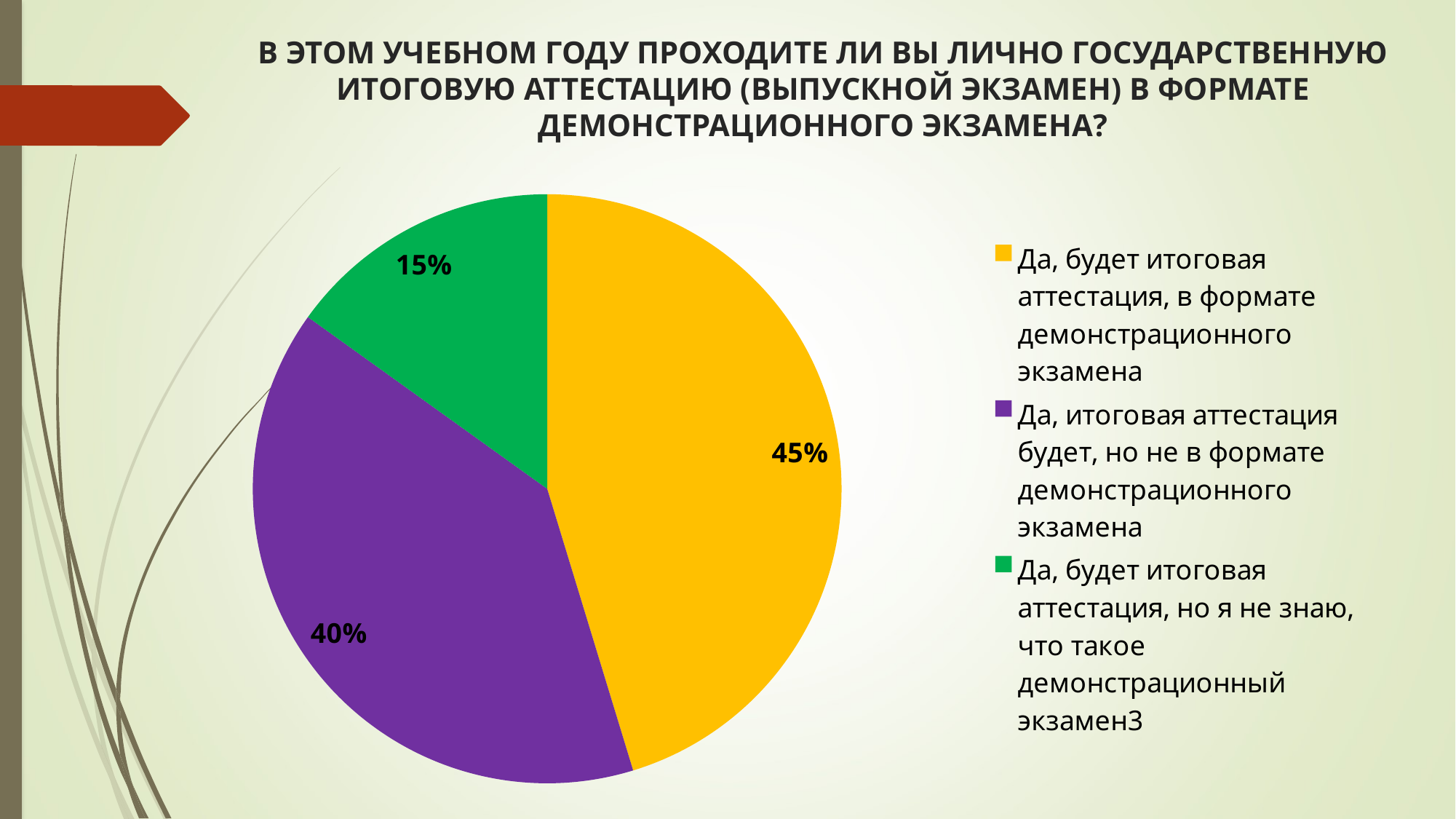
What colour is the slice representing 15%? green Which slice is larger: the purple one or the green one? the purple one What kind of chart is shown on the slide? pie chart What share of respondents answered "Да, итоговая аттестация будет, но не в формате демонстрационного экзамена"? 40% Which answer option has the smallest share of the pie? Да, будет итоговая аттестация, но я не знаю, что такое демонстрационный экзамен What share of respondents answered "Да, будет итоговая аттестация, но я не знаю, что такое демонстрационный экзамен"? 15% Which answer option has the largest share of the pie? Да, будет итоговая аттестация, в формате демонстрационного экзамена How many slices does the pie chart have? 3 What is the difference in percentage points between the 45% slice and the 15% slice? 30 percentage points What is the difference in percentage points between the yellow slice and the purple slice? 5 percentage points How many entries does the legend list? 3 What share of respondents answered "Да, будет итоговая аттестация, в формате демонстрационного экзамена"? 45%